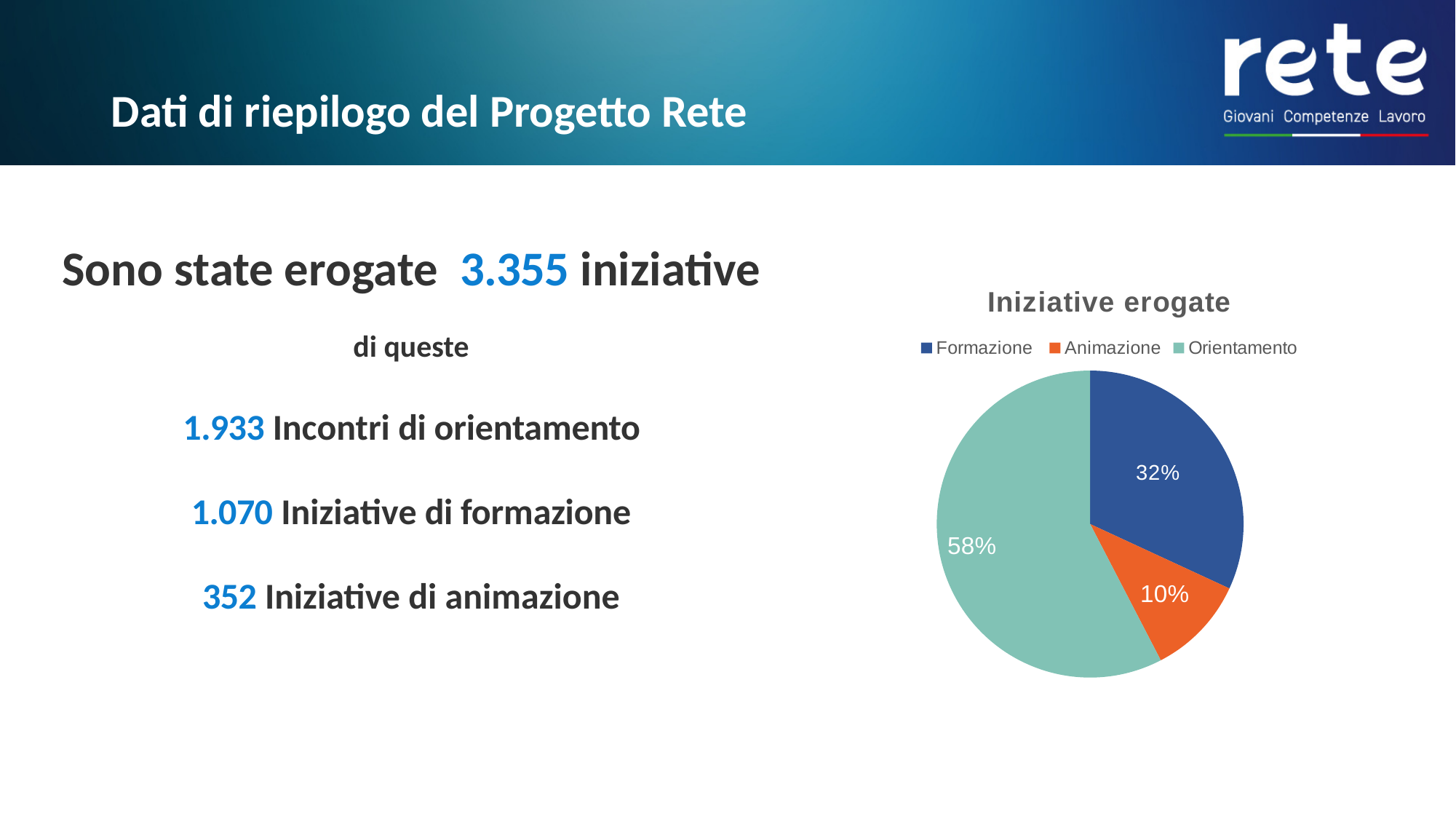
How many categories does the legend of the pie chart list? 3 Which slice is larger, Formazione or Animazione? Formazione Which colour is used for the Animazione slice? orange What is the difference in percentage points between the Orientamento and Formazione slices? 26% What is the title of the chart? Iniziative erogate How many slices does the pie chart have? 3 Which category has the smallest slice of the pie? Animazione What share of the pie does Formazione represent? 32% What share of the pie does Orientamento represent? 58% What type of chart is shown on the slide? pie chart Which category has the largest slice of the pie? Orientamento What share of the pie does Animazione represent? 10%